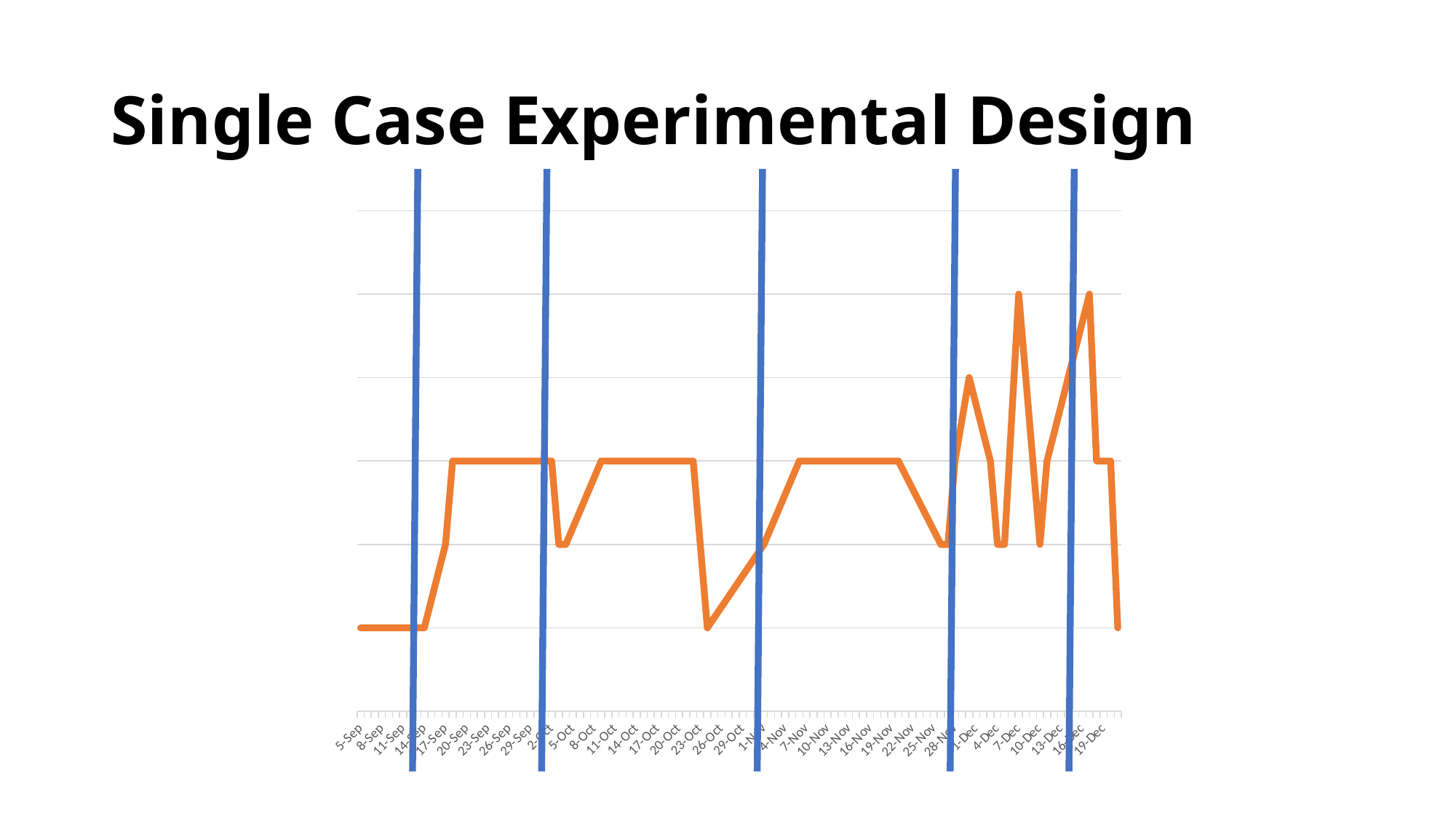
How many blue vertical lines are drawn across the chart? 5 Does the plotted line rise or fall between 26-Oct and 7-Nov? rise How many data series (lines) are plotted in the chart? 1 What colour is the plotted data line in the chart? orange How many date labels are shown on the x axis of the chart? 36 What is the first date label on the x axis of the chart? 5-Sep What kind of chart is shown on the slide? line chart What is the last date label on the x axis of the chart? 19-Dec Which is lower on the chart, the value at 23-Oct or the value at 20-Oct? 23-Oct Which is higher on the chart, the value at 20-Sep or the value at 5-Sep? 20-Sep Does the plotted line rise or fall between 19-Nov and 25-Nov? fall Does the plotted line rise or fall between 14-Sep and 20-Sep? rise